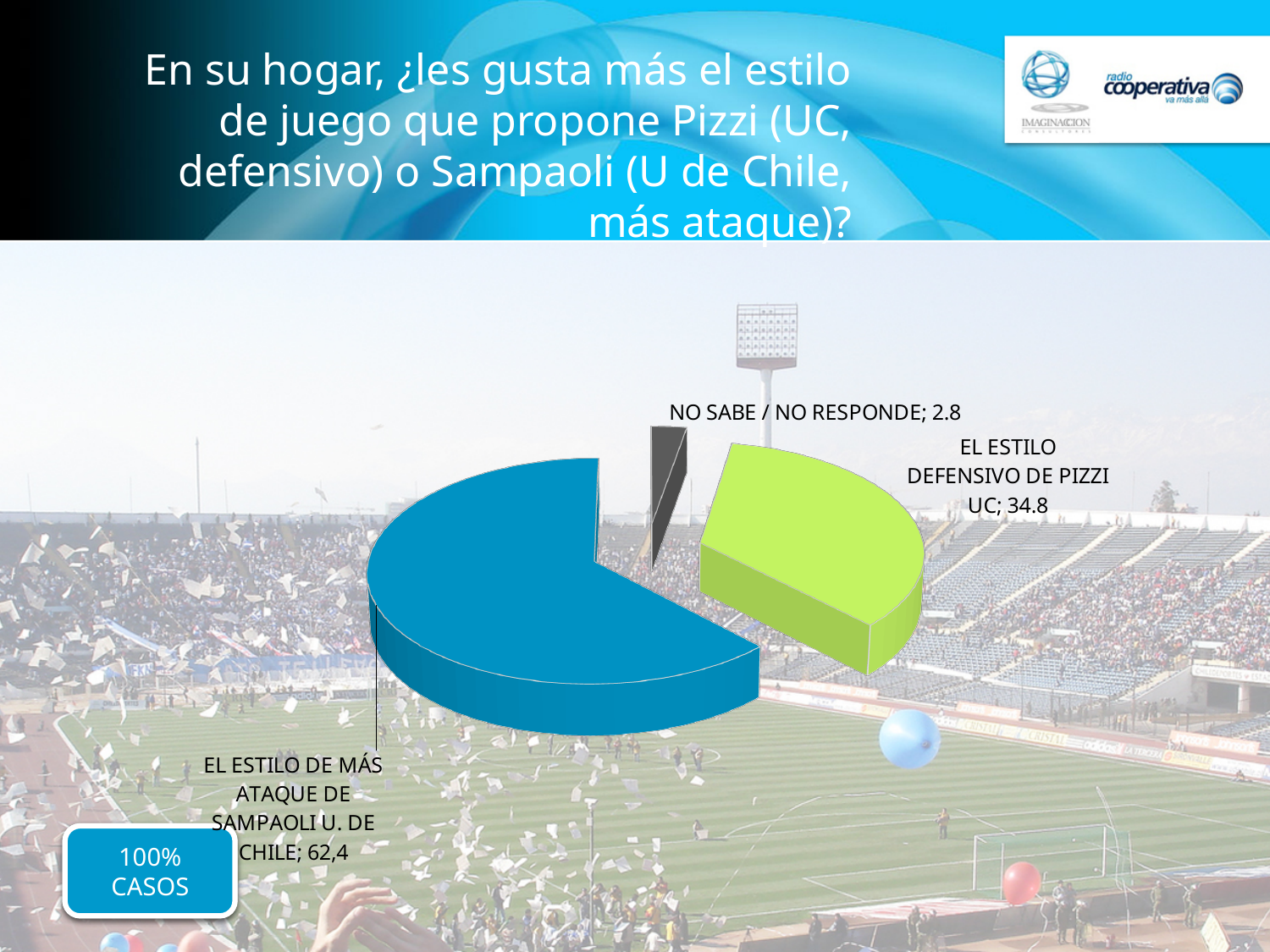
What value is shown for the slice labelled NO SABE / NO RESPONDE? 2.8 Which is larger: the value for EL ESTILO DEFENSIVO DE PIZZI UC or the value for NO SABE / NO RESPONDE? EL ESTILO DEFENSIVO DE PIZZI UC What is the difference between the value for EL ESTILO DEFENSIVO DE PIZZI UC and the value for NO SABE / NO RESPONDE? 32 What value is shown for the slice labelled EL ESTILO DEFENSIVO DE PIZZI UC? 34.8 What is the difference between the value for EL ESTILO DE MÁS ATAQUE DE SAMPAOLI U. DE CHILE and the value for EL ESTILO DEFENSIVO DE PIZZI UC? 27.6 What kind of chart is shown on the slide? pie chart What colour is the slice for EL ESTILO DE MÁS ATAQUE DE SAMPAOLI U. DE CHILE? blue Which slice of the pie chart has the largest value? EL ESTILO DE MÁS ATAQUE DE SAMPAOLI U. DE CHILE What value is shown for the slice labelled EL ESTILO DE MÁS ATAQUE DE SAMPAOLI U. DE CHILE? 62,4 What colour is the slice for EL ESTILO DEFENSIVO DE PIZZI UC? green Which slice of the pie chart has the smallest value? NO SABE / NO RESPONDE How many slices does the pie chart have? 3